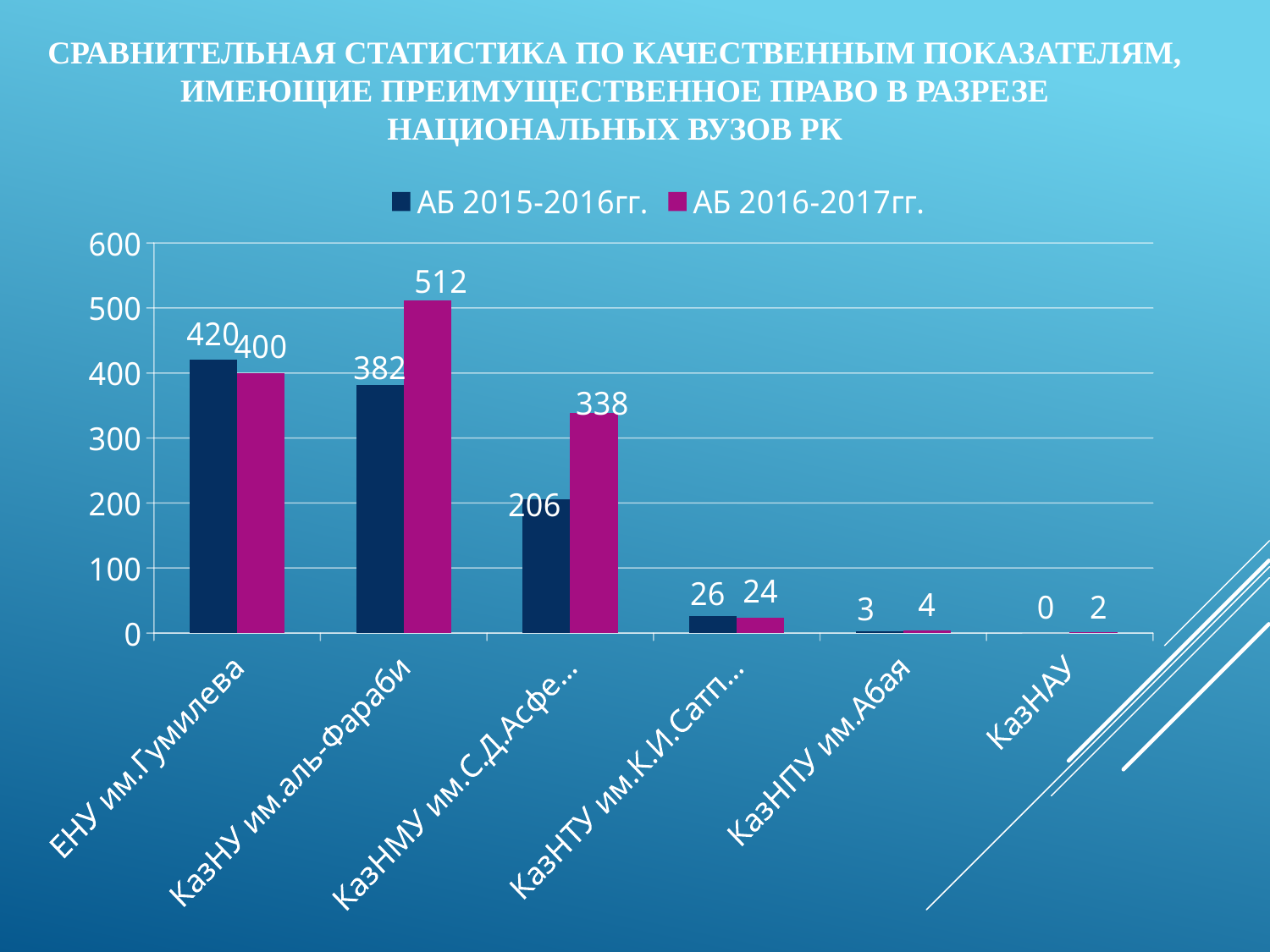
Which university has the lowest value in the АБ 2015-2016гг. series? КазНАУ What is the difference between the АБ 2016-2017гг. and АБ 2015-2016гг. values for КазНУ им.аль-Фараби? 130 How many series does the legend list? 2 What is the value for КазНУ им.аль-Фараби in the АБ 2016-2017гг. series? 512 What is the value for КазНАУ in the АБ 2016-2017гг. series? 2 What is the value for ЕНУ им.Гумилева in the АБ 2015-2016гг. series? 420 What type of chart is shown on the slide? bar chart Which series is shown in magenta in the legend? АБ 2016-2017гг. How many universities (categories) are shown on the x axis? 6 What is the value for КазНПУ им.Абая in the АБ 2015-2016гг. series? 3 Which university has the highest value in the АБ 2016-2017гг. series? КазНУ им.аль-Фараби For ЕНУ им.Гумилева, which series has the larger value: АБ 2015-2016гг. or АБ 2016-2017гг.? АБ 2015-2016гг.